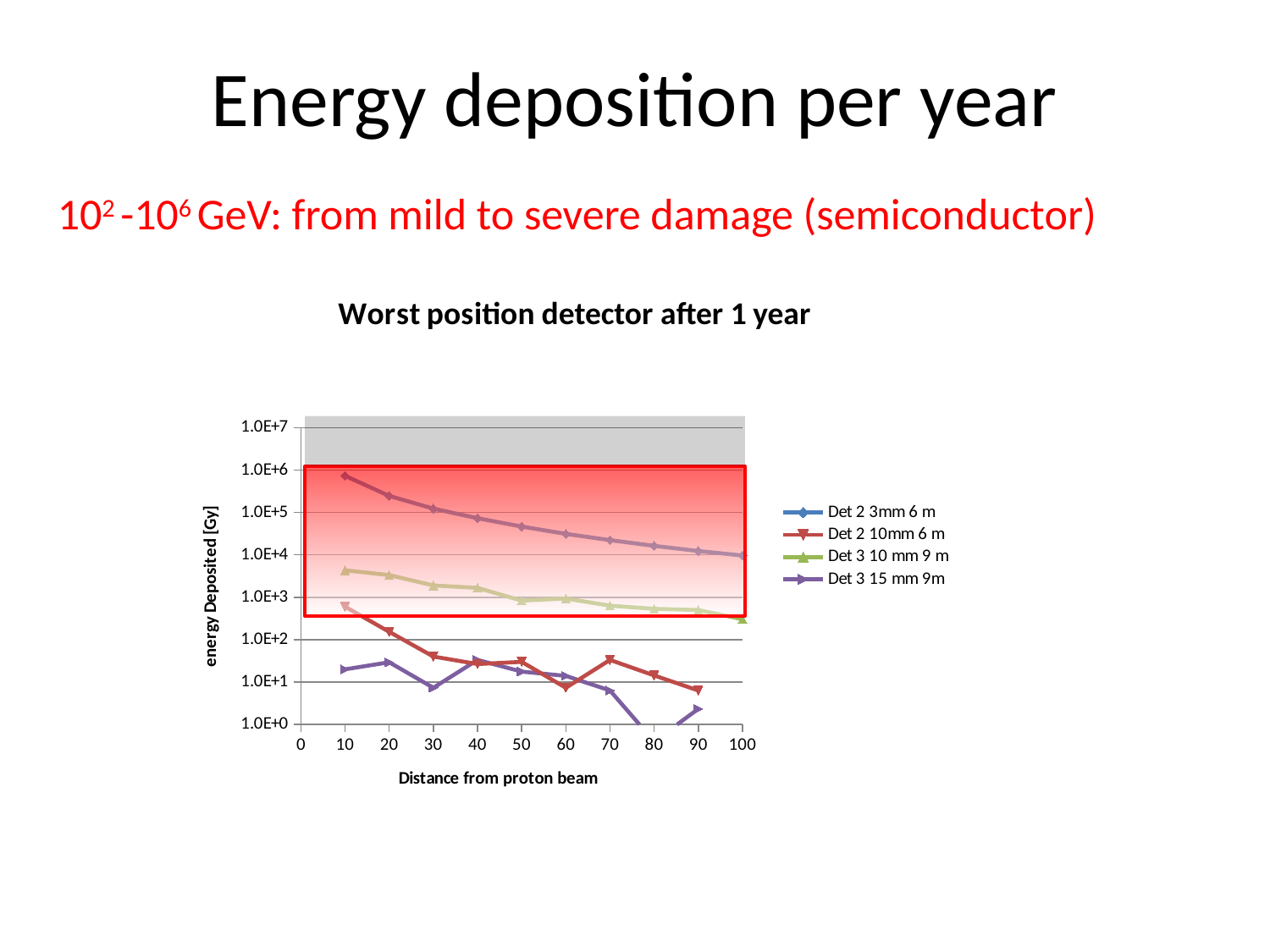
Which series has the highest energy deposited at a distance of 10? Det 2 3mm 6 m Is the value for Det 3 10 mm 9 m at distance 10 greater or less than 1.0E+3? greater What is the label of the y axis? energy Deposited [Gy] Is the value for Det 2 10mm 6 m at distance 10 greater or less than 1.0E+3? less At distance 10, which is larger: the value for Det 3 10 mm 9 m or the value for Det 2 10mm 6 m? Det 3 10 mm 9 m What is the title of the chart? Worst position detector after 1 year Is the value for Det 2 3mm 6 m at distance 10 greater or less than 1.0E+5? greater Does the energy deposited for Det 2 3mm 6 m rise or fall as the distance from the proton beam increases? fall How many series does the legend list? 4 What kind of chart is shown on the slide? line chart Which series has the lowest energy deposited at a distance of 10? Det 3 15 mm 9m